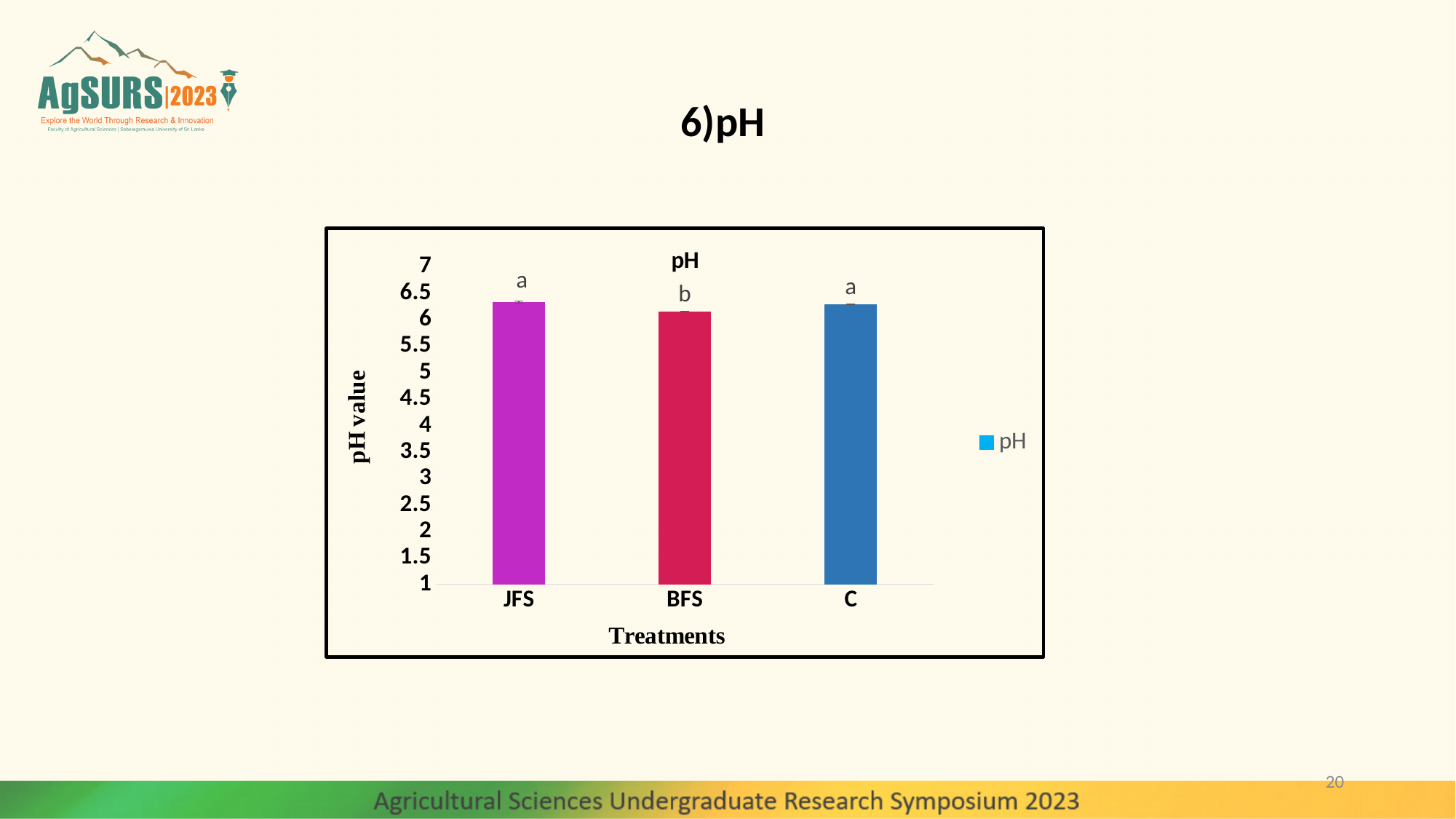
Which has the larger pH value, JFS or BFS? JFS What is the label of the x axis of the chart? Treatments Is the pH value for BFS greater or less than 6.5? less How many series does the legend of the pH chart list? 1 What kind of chart is shown on the slide? bar chart Which treatment has the lowest pH value in the chart? BFS Is the pH value for JFS greater or less than 6? greater How many treatments are plotted on the x axis of the pH chart? 3 What is the title of the chart? pH Is the pH value for C greater or less than 6.5? less What is the label of the y axis of the chart? pH value